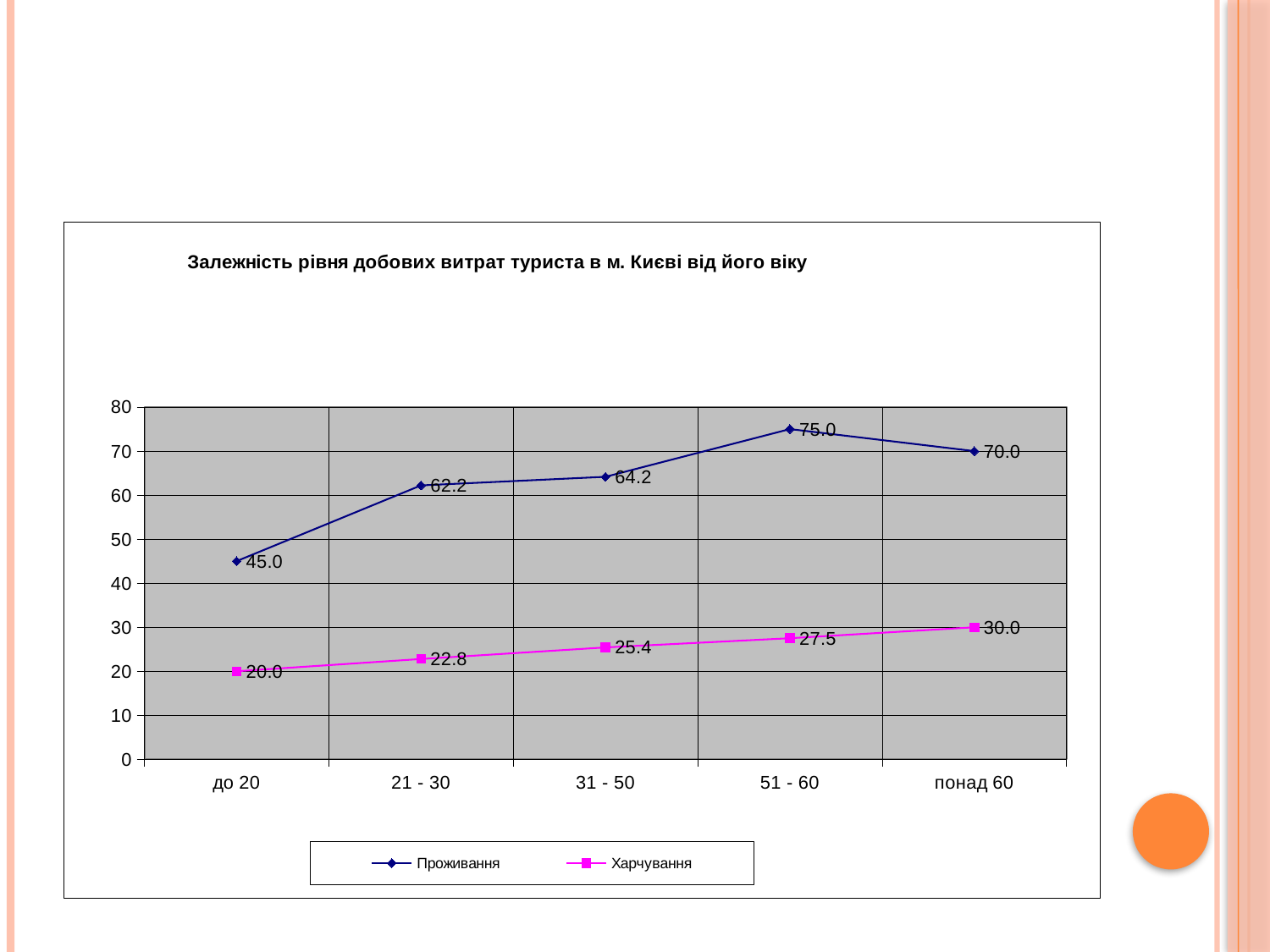
What is the title of the chart? Залежність рівня добових витрат туриста в м. Києві від його віку How many series does the legend list? 2 Does the Харчування series rise or fall from до 20 to понад 60? Rise What is the value for Харчування in the 51 - 60 age group? 27.5 Which is larger: Проживання for 31 - 50 or Проживання for 21 - 30? Проживання for 31 - 50 What is the value for Проживання in the 21 - 30 age group? 62.2 Which age group has the lowest value for Харчування? до 20 Which age group has the highest value for Проживання? 51 - 60 What is the value for Проживання for понад 60? 70.0 How many age groups are shown on the x axis? 5 What kind of chart is shown on the slide? Line chart What is the difference between Проживання and Харчування for the до 20 age group? 25.0